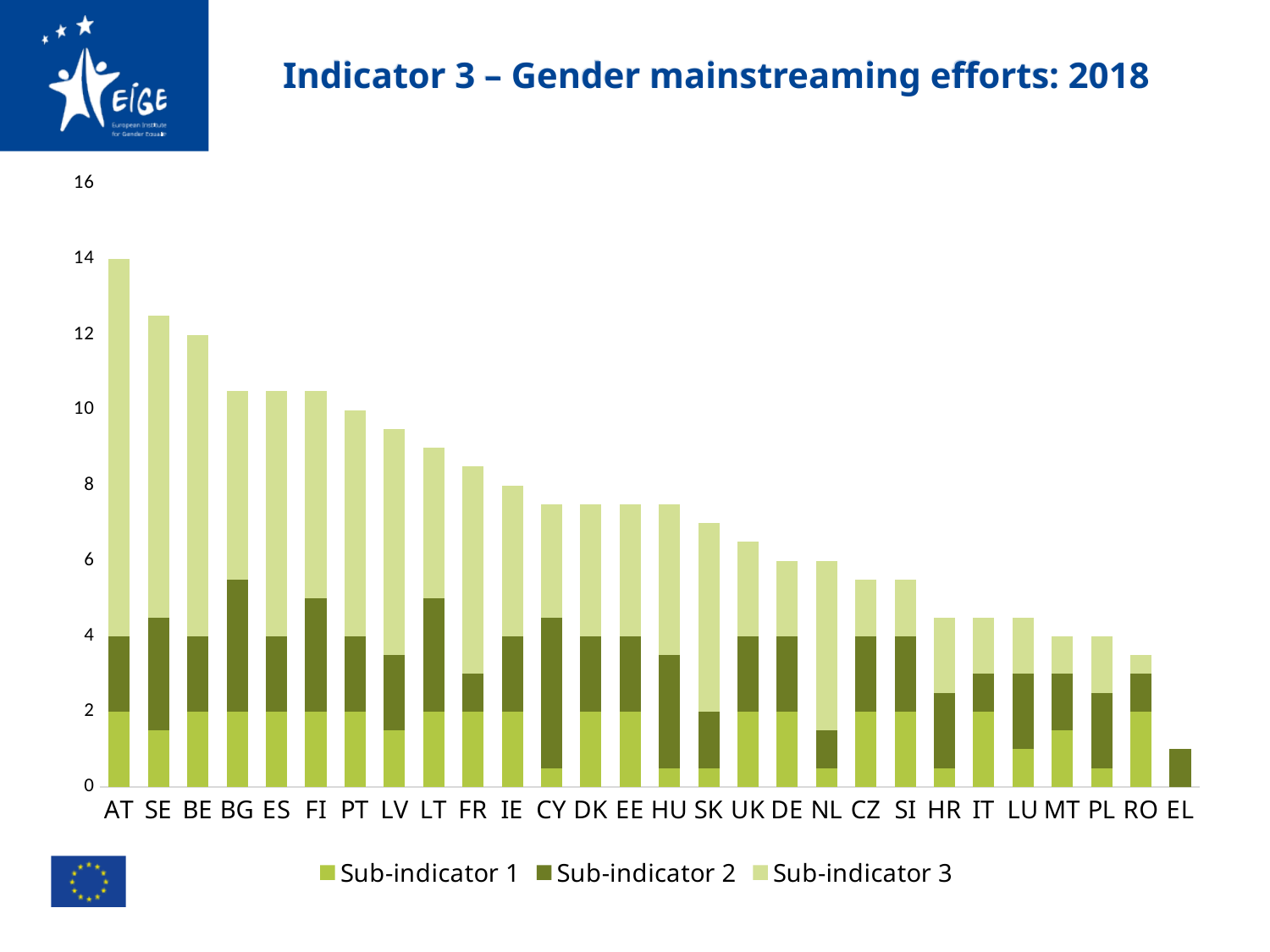
Is the total value for EL greater or less than 2? less Which has the larger total bar, AT or SE? AT What kind of chart is shown on the slide? Stacked bar chart Is the total value for RO greater or less than 4? less What is the title of the chart? Indicator 3 – Gender mainstreaming efforts: 2018 How many series does the legend list? 3 Is the total value for SK greater or less than 6? greater Do the total bar values rise or fall from left to right along the x axis? fall Which country has the highest total bar? AT How many countries are shown on the x axis? 28 Which country has the lowest total bar? EL